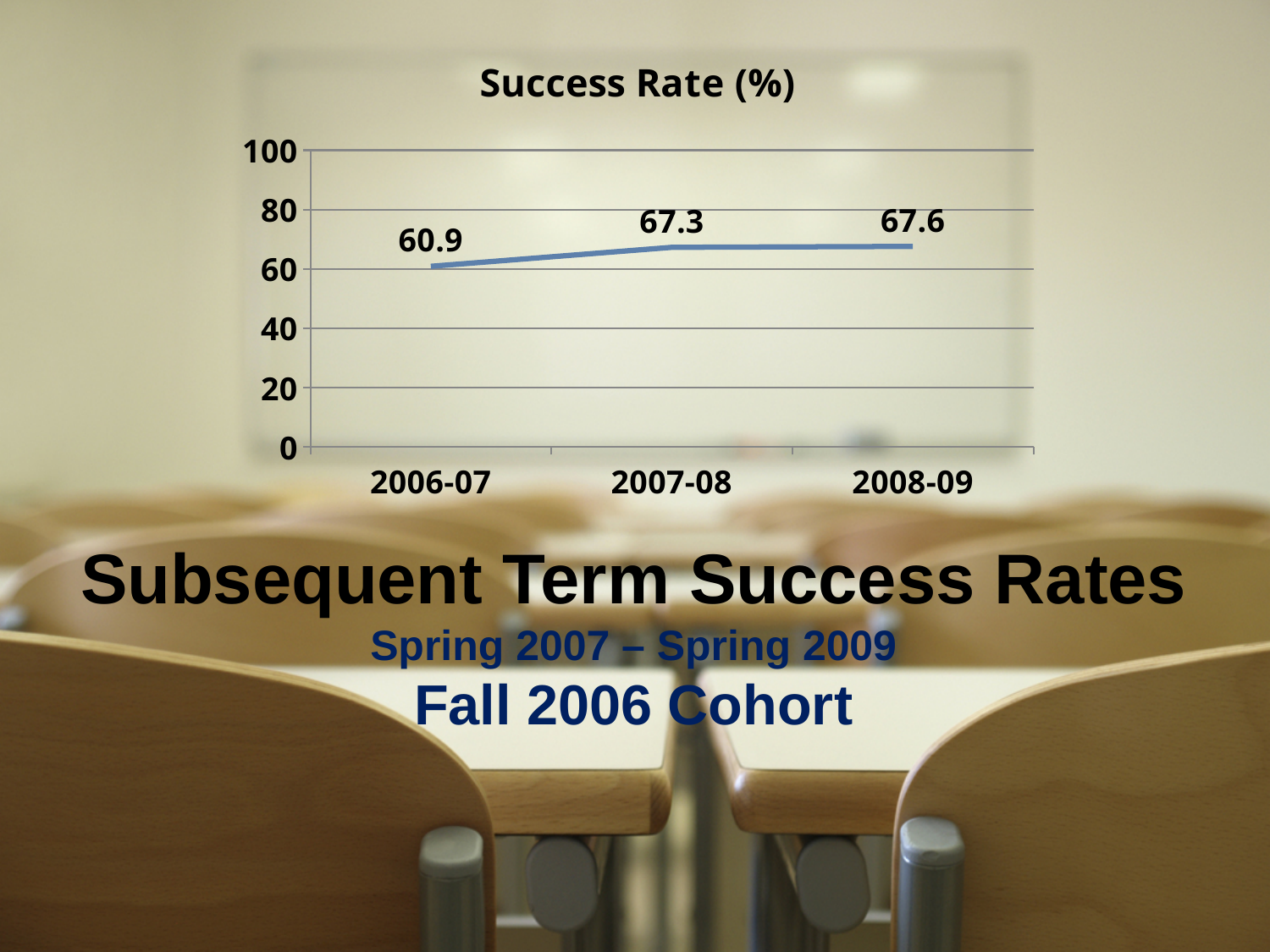
What is the title of the chart? Success Rate (%) Is the success rate for 2006-07 greater or less than 80? less How many years are plotted on the chart? 3 What is the success rate for 2007-08? 67.3 Which year has the lowest success rate? 2006-07 What is the success rate for 2006-07? 60.9 What is the difference in success rate between 2008-09 and 2006-07? 6.7 What is the difference in success rate between 2007-08 and 2006-07? 6.4 What kind of chart is shown on the slide? line chart Which is larger, the success rate for 2006-07 or for 2007-08? 2007-08 What is the success rate for 2008-09? 67.6 Does the success rate rise or fall from 2006-07 to 2008-09? rise